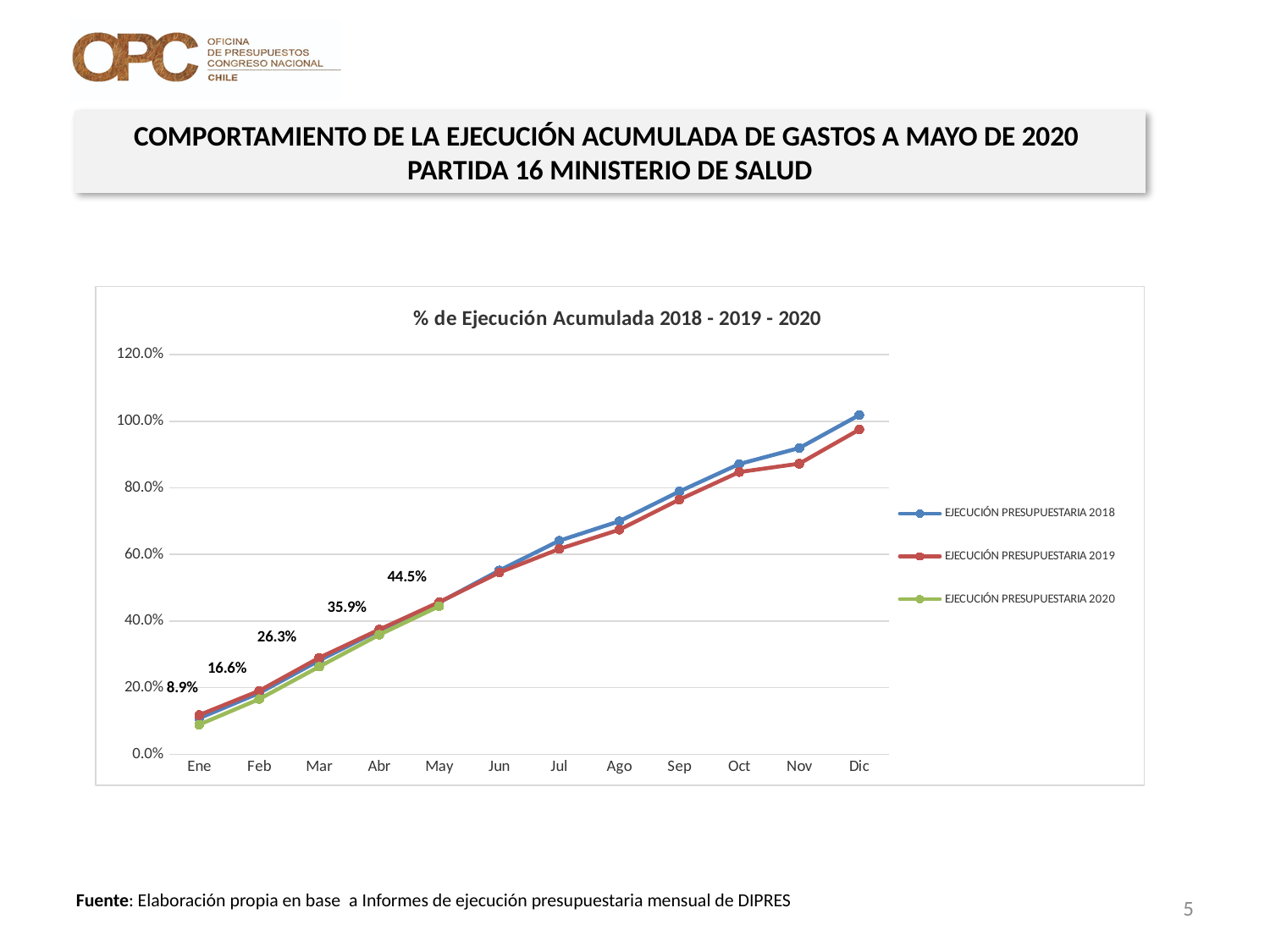
What is the value for EJECUCIÓN PRESUPUESTARIA 2020 in Mar? 26.3% How many months are shown on the x axis of the chart? 12 What type of chart is shown on the slide? Line chart Is the value for EJECUCIÓN PRESUPUESTARIA 2018 in Oct greater or less than 80.0%? greater What is the value for EJECUCIÓN PRESUPUESTARIA 2020 in May? 44.5% What is the title of the chart? % de Ejecución Acumulada 2018 - 2019 - 2020 What is the value for EJECUCIÓN PRESUPUESTARIA 2020 in Ene? 8.9% Is the value for EJECUCIÓN PRESUPUESTARIA 2019 in Dic greater or less than 100.0%? less What is the difference between the 2020 values for May and Ene? 35.6 percentage points In which month does the EJECUCIÓN PRESUPUESTARIA 2020 series reach its highest value? May How many series does the chart legend list? 3 In Dic, which series has the higher value: EJECUCIÓN PRESUPUESTARIA 2018 or EJECUCIÓN PRESUPUESTARIA 2019? EJECUCIÓN PRESUPUESTARIA 2018